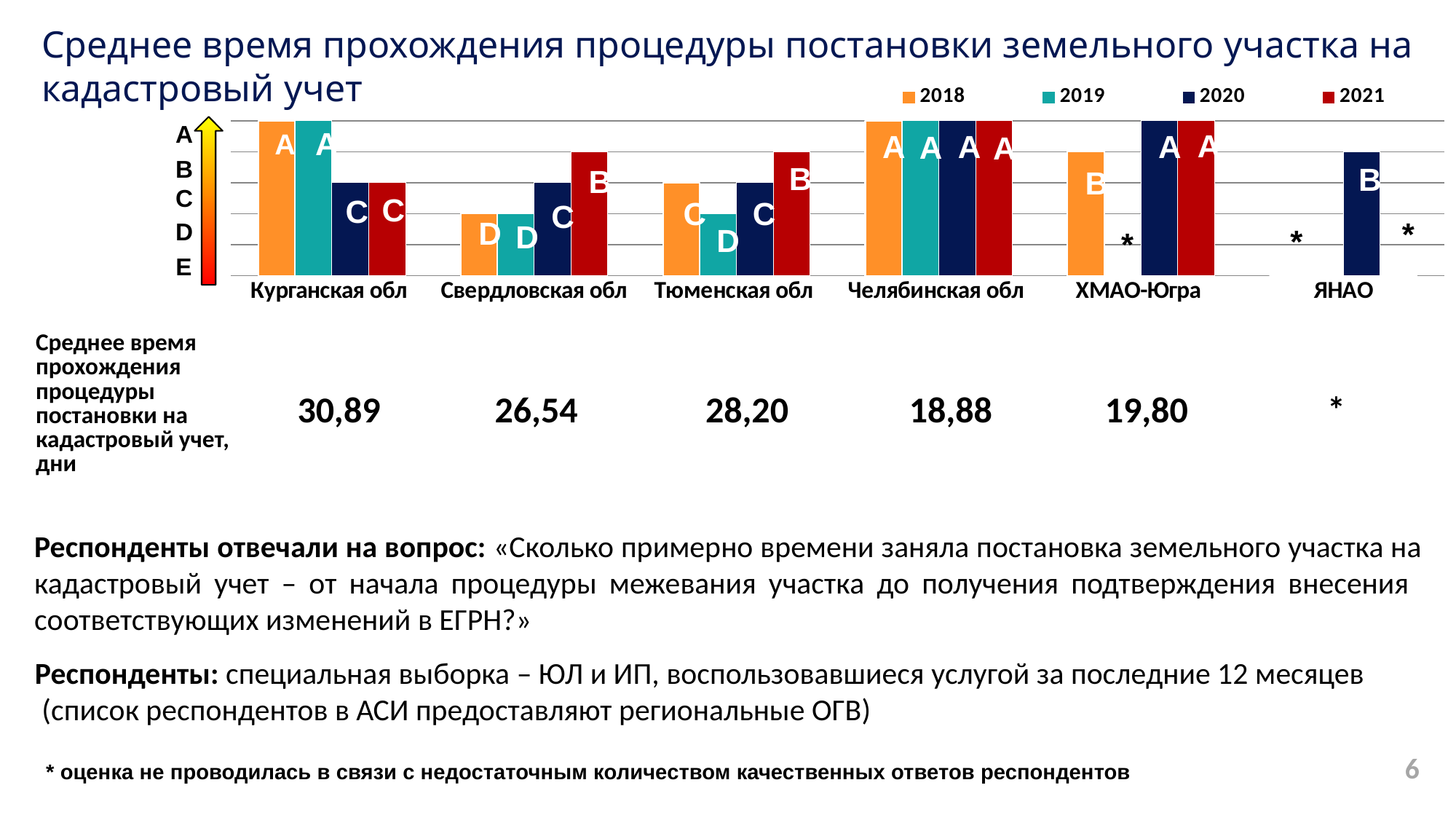
How many regions are shown on the x axis of the chart? 6 Which years are listed in the chart legend? 2018, 2019, 2020, 2021 What kind of chart is shown on the slide? bar chart Which region has the lowest average time (days) for the cadastral registration procedure shown below the chart? Челябинская обл What grade is shown for Свердловская обл in 2018? D Which region has the highest average time (days) for the cadastral registration procedure shown below the chart? Курганская обл What is the difference in average time (days) between Курганская обл and Челябинская обл? 12,01 What grade is shown for ХМАО-Югра in 2020? A What grade is shown for Тюменская обл in 2021? B What grade is shown for Курганская обл in 2021? C How many series does the legend list? 4 What grade is shown for ЯНАО in 2020? B